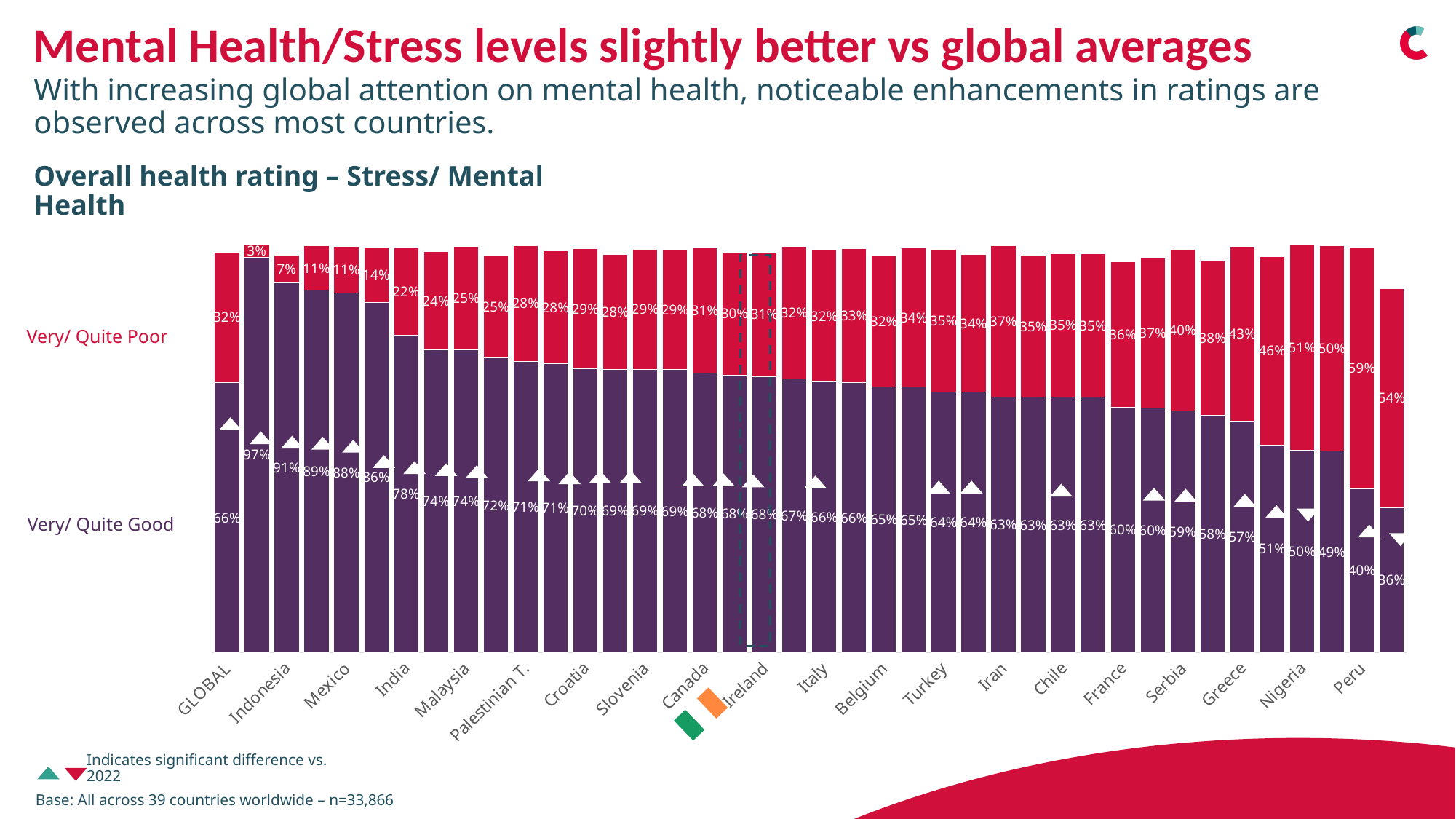
What is the Very/Quite Good value for Indonesia? 91% What is the Very/Quite Poor value for GLOBAL? 32% What colour represents the Very/Quite Poor segment in the chart? Red Which has a higher Very/Quite Good value, Ireland or GLOBAL? Ireland What kind of chart is used to show the overall health rating for stress/mental health? Stacked bar chart What is the Very/Quite Good value for Ireland? 68% What percentage of GLOBAL respondents rate their stress/mental health as Very/Quite Good? 66% What is the Very/Quite Poor value for Ireland? 31% Do the Very/Quite Good values rise or fall moving from left to right across the countries? Fall How many series are shown in the chart? 2 By how many percentage points does Ireland's Very/Quite Good value exceed the GLOBAL value? 2 percentage points What is the Very/Quite Good value for Peru? 40%